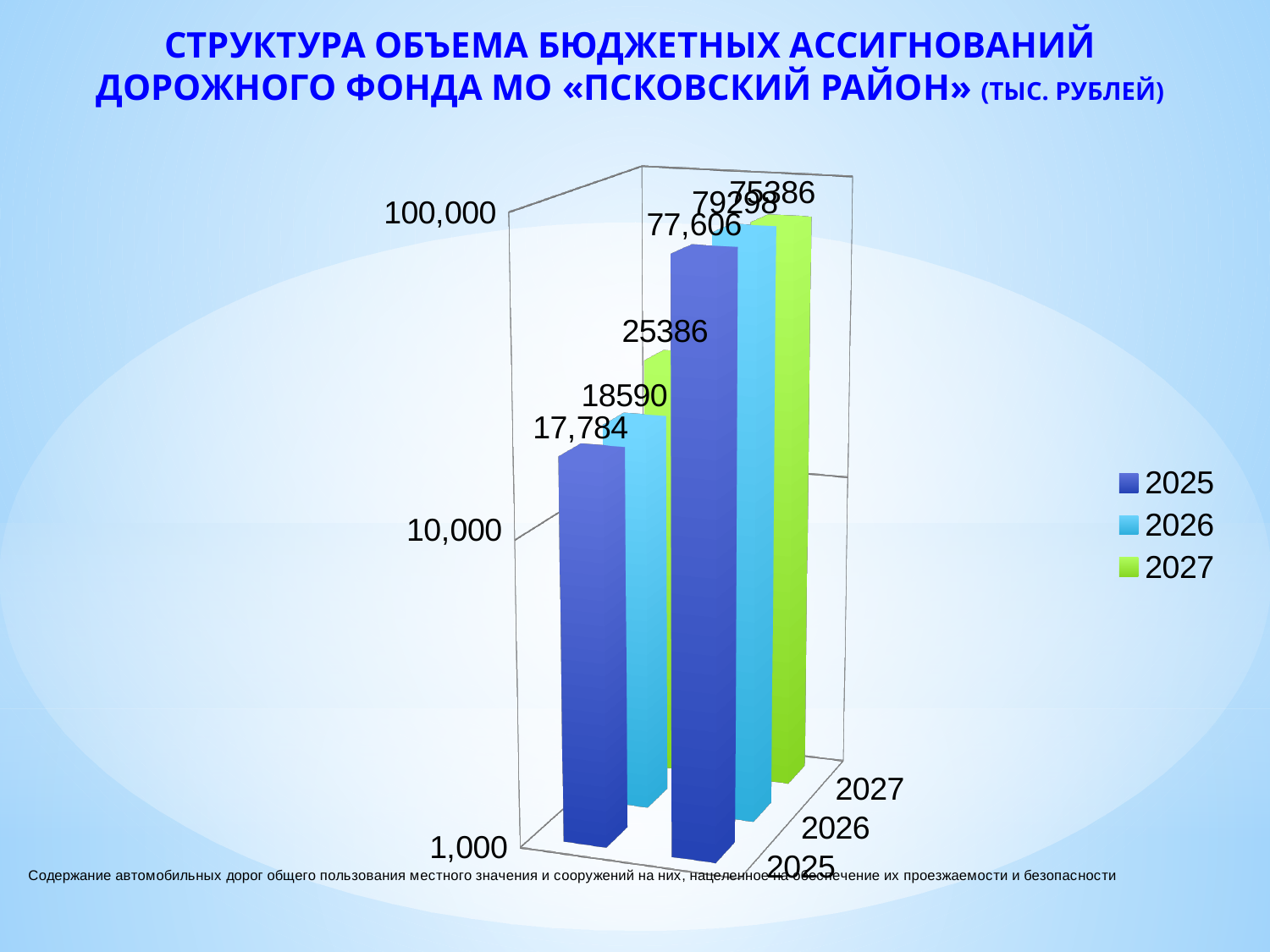
In the left (smaller) group of bars, which year has the highest value? 2027 How many series does the legend list? 3 What is the difference between the 2027 and 2025 values in the left (smaller) group of bars? 7602 What kind of chart is shown on the slide? bar chart Which years are listed in the legend? 2025, 2026, 2027 How many groups of bars are plotted on the chart? 2 What is the value of the 2025 bar in the right (taller) group of bars? 77,606 What is the value of the 2026 bar in the left (smaller) group of bars? 18590 In the left (smaller) group of bars, is the 2025 value greater or less than 10,000? greater What is the value of the 2027 bar in the left (smaller) group of bars? 25386 What is the value of the 2025 bar in the left (smaller) group of bars? 17,784 What is the value of the 2027 bar in the right (taller) group of bars? 75386